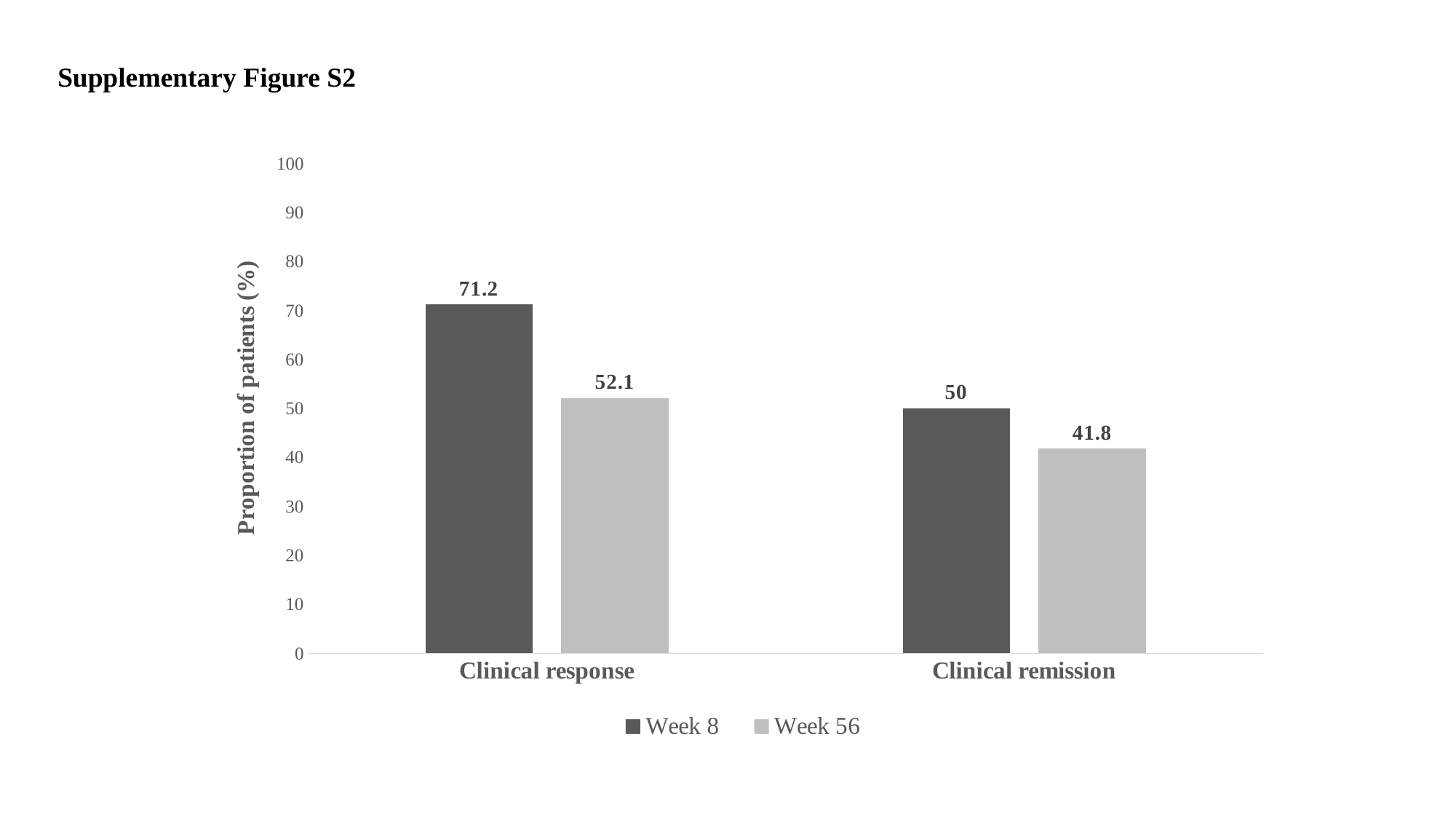
What is the difference between the Week 8 and Week 56 values for Clinical response? 19.1 How many series does the legend list? 2 Which is larger: the Week 56 value for Clinical response or the Week 8 value for Clinical remission? Week 56 value for Clinical response What is the difference between the Week 8 and Week 56 values for Clinical remission? 8.2 What is the Week 8 value for Clinical response? 71.2 What kind of chart is shown on the slide? Bar chart What is the Week 8 value for Clinical remission? 50 What is the Week 56 value for Clinical response? 52.1 What is the Week 56 value for Clinical remission? 41.8 Which bar has the lowest value on the chart? Week 56, Clinical remission Which bar has the highest value on the chart? Week 8, Clinical response How many categories are shown on the x axis? 2